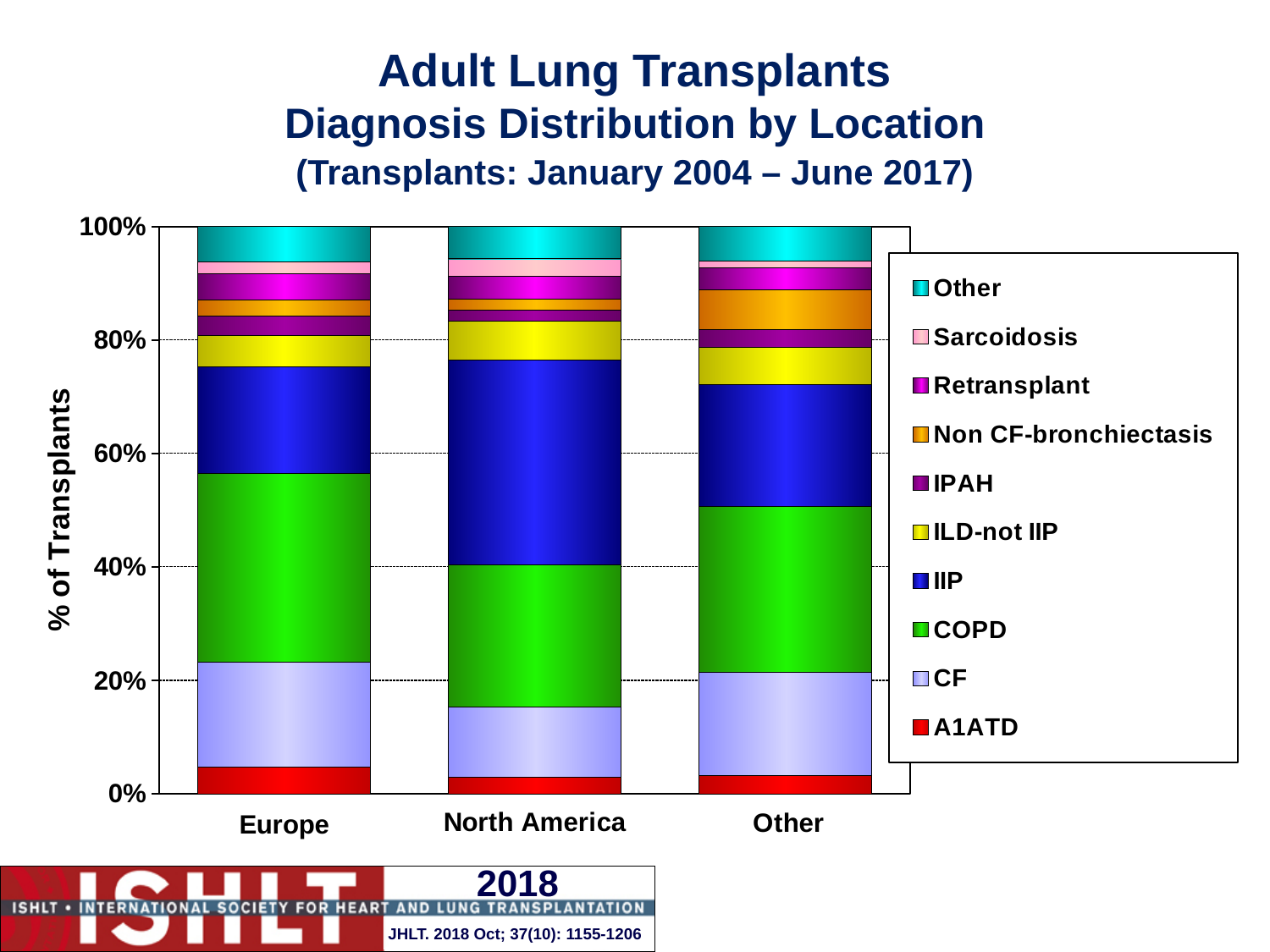
How many diagnosis categories does the legend list? 10 Is the COPD share for Europe larger or smaller than the COPD share for North America? larger What does each stacked bar total? 100% Is the CF share for North America larger or smaller than the CF share for Europe? smaller Is the A1ATD share for Europe greater or less than 20%? less Is the IIP share for North America greater or less than 20%? greater Which location has the largest Non CF-bronchiectasis segment? Other How many locations are shown along the x axis? 3 What is the title of the chart? Adult Lung Transplants Diagnosis Distribution by Location What kind of chart is shown on the slide? Stacked bar chart Which location has the largest IIP segment? North America What is the label of the y axis? % of Transplants